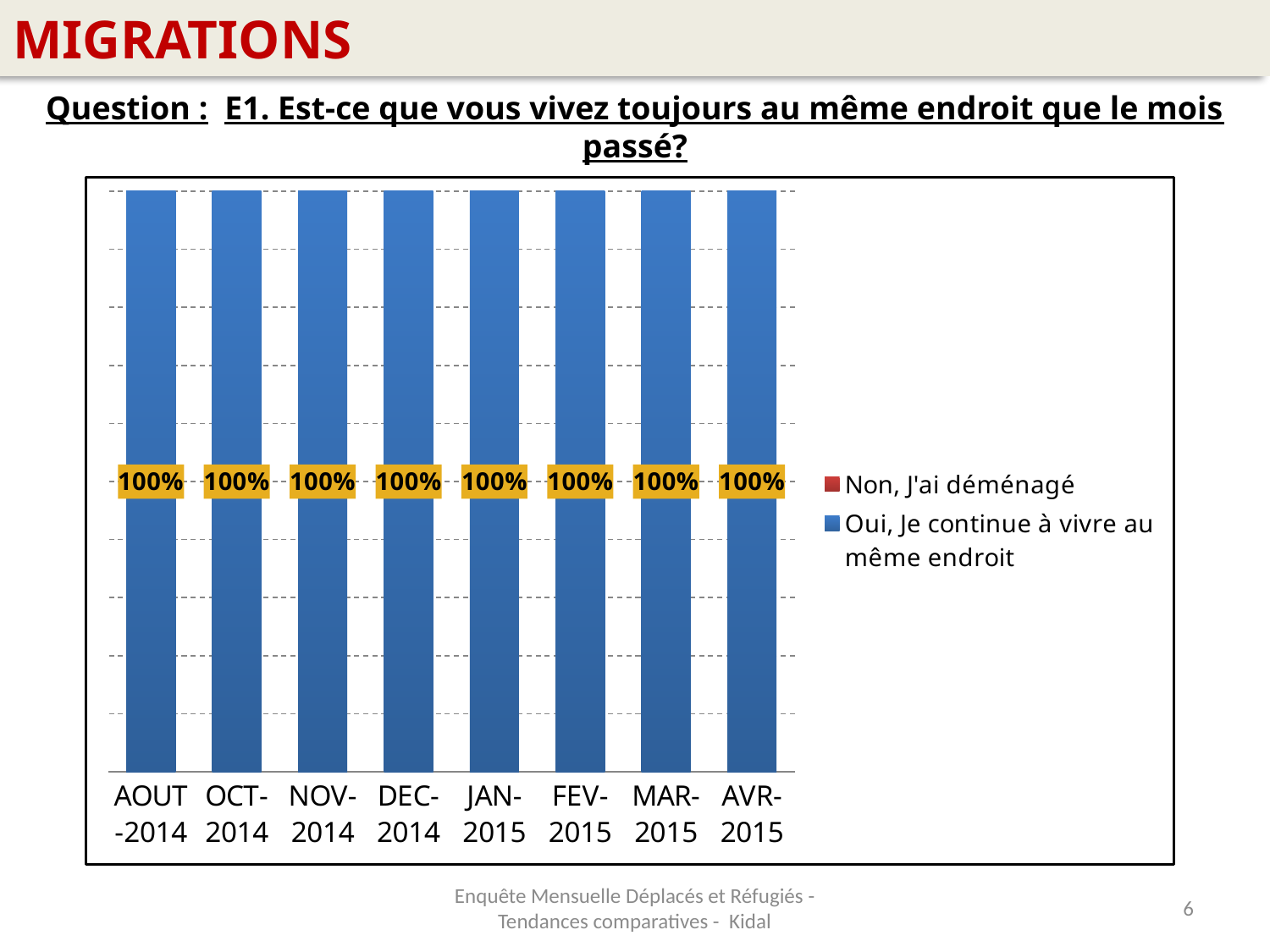
What is the value shown for 'Oui, Je continue à vivre au même endroit' in AOUT-2014? 100% What is the value shown for 'Oui, Je continue à vivre au même endroit' in JAN-2015? 100% What is the difference between the values for DEC-2014 and MAR-2015? 0% What is the first month shown on the x axis of the chart? AOUT-2014 Do the values for 'Oui, Je continue à vivre au même endroit' rise, fall or stay the same from AOUT-2014 to AVR-2015? stay the same Which series is shown in red in the legend? Non, J'ai déménagé What is the last month shown on the x axis of the chart? AVR-2015 How many series does the chart legend list? 2 How many months (categories) are shown on the x axis of the chart? 8 What is the value shown for 'Oui, Je continue à vivre au même endroit' in AVR-2015? 100% Which series is shown in blue in the legend? Oui, Je continue à vivre au même endroit What kind of chart is shown on the slide? bar chart